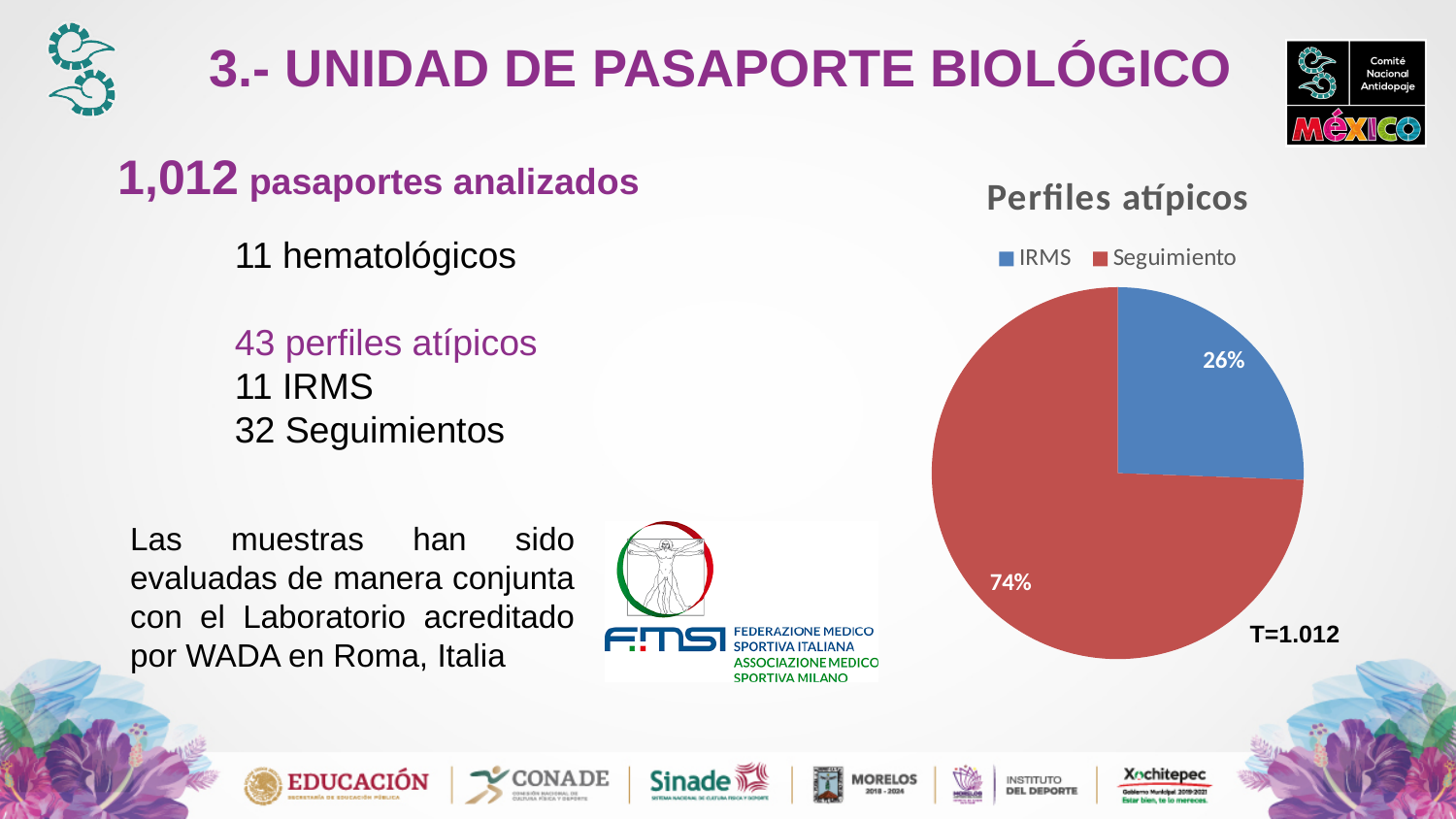
How many slices does the pie chart have? 2 What is the title of the chart? Perfiles atípicos What type of chart is shown on the slide? pie chart How many entries does the legend list? 2 Which slice is the smallest in the pie chart? IRMS Which slice is the largest in the pie chart? Seguimiento What percentage does the IRMS slice show? 26% What total is printed next to the pie chart? T=1.012 What colour is the Seguimiento slice? red Which is larger, the IRMS slice or the Seguimiento slice? Seguimiento What percentage does the Seguimiento slice show? 74% What is the difference in percentage points between the Seguimiento slice and the IRMS slice? 48